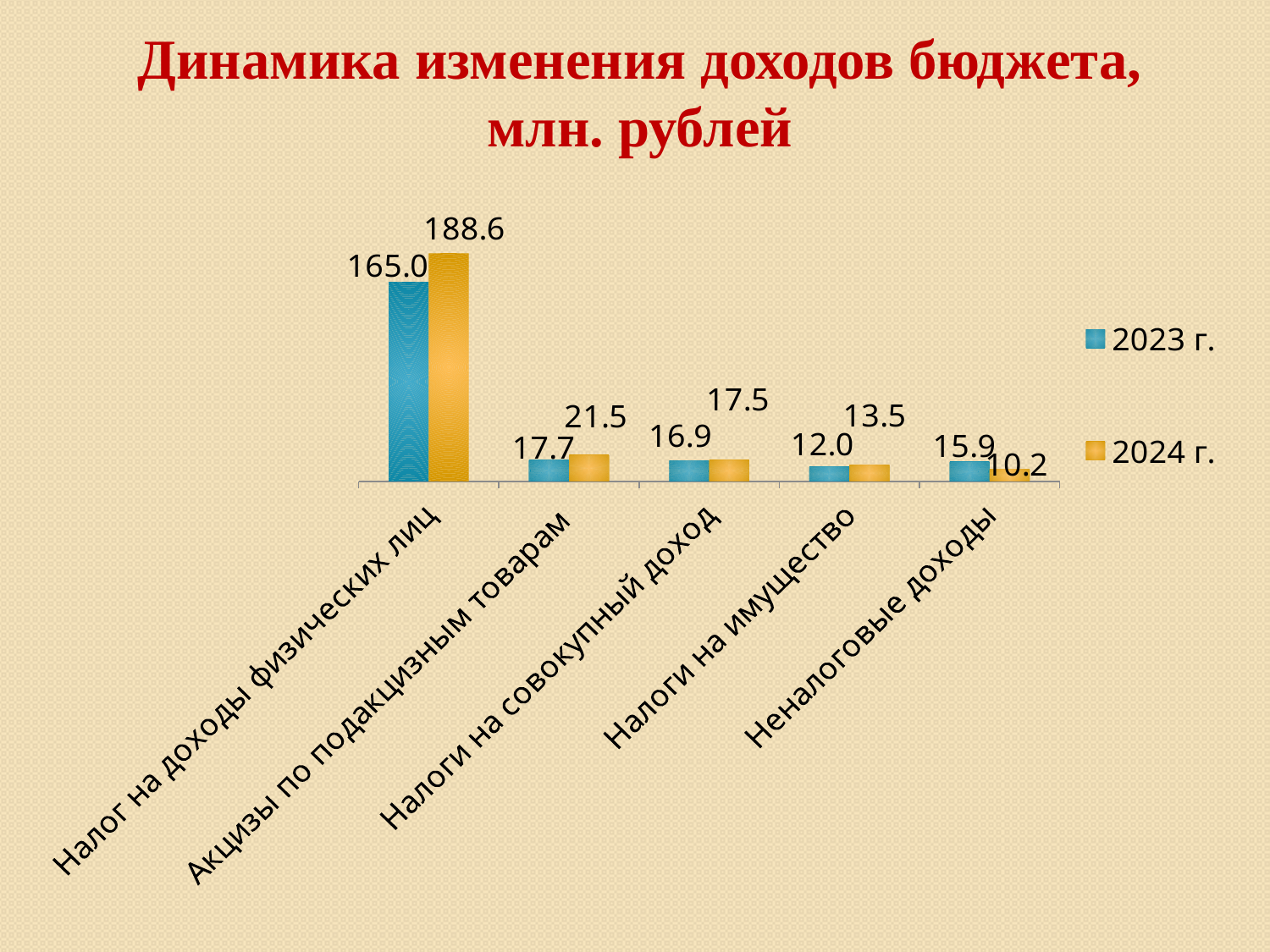
What kind of chart is shown on the slide? Bar chart What is the difference between the 2024 г. and 2023 г. values for Налог на доходы физических лиц? 23.6 Which category has the highest value for 2024 г.? Налог на доходы физических лиц What is the value for 2023 г. for Налоги на имущество? 12.0 What is the value for 2024 г. for Налог на доходы физических лиц? 188.6 What is the value for 2024 г. for Акцизы по подакцизным товарам? 21.5 What is the value for 2024 г. for Неналоговые доходы? 10.2 What is the value for 2023 г. for Налог на доходы физических лиц? 165.0 How many categories are shown on the x axis? 5 Which is larger for Неналоговые доходы: the 2023 г. value or the 2024 г. value? 2023 г. How many series does the legend list? 2 Which category has the lowest value for 2023 г.? Налоги на имущество